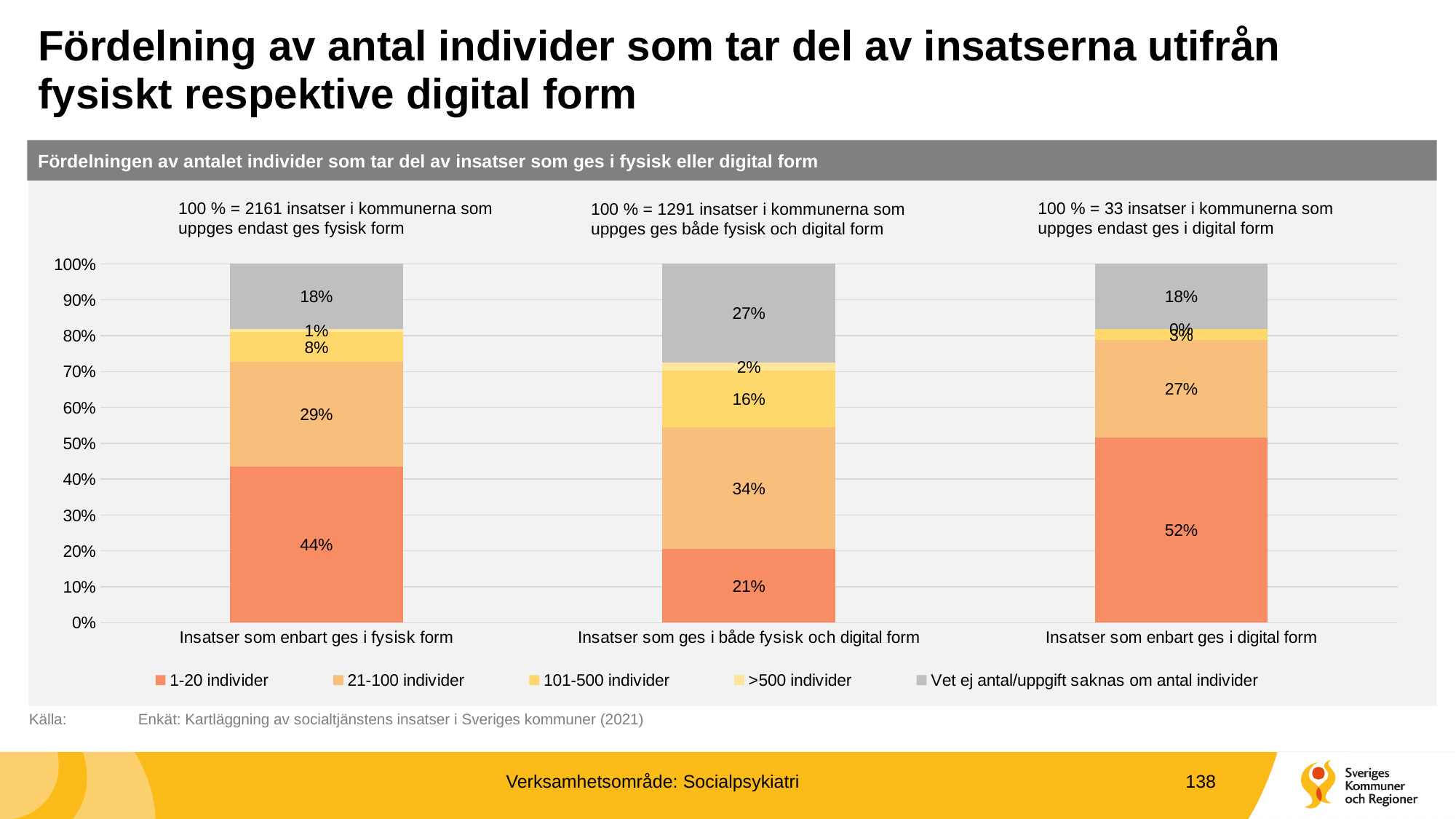
Which category has the highest share of '1-20 individer'? Insatser som enbart ges i digital form Which has a larger share of '21-100 individer': 'Insatser som enbart ges i fysisk form' or 'Insatser som ges i både fysisk och digital form'? Insatser som ges i både fysisk och digital form What is the share of '101-500 individer' for 'Insatser som ges i både fysisk och digital form'? 16% How many series does the legend list? 5 What is the share of 'Vet ej antal/uppgift saknas om antal individer' for 'Insatser som ges i både fysisk och digital form'? 27% What kind of chart is shown on the slide? Stacked bar chart What is the share of '21-100 individer' for 'Insatser som ges i både fysisk och digital form'? 34% What percentage of the 'Insatser som enbart ges i fysisk form' bar is '1-20 individer'? 44% What is the share of '1-20 individer' for 'Insatser som enbart ges i digital form'? 52% What is the difference in the '1-20 individer' share between 'Insatser som enbart ges i fysisk form' and 'Insatser som ges i både fysisk och digital form'? 23 percentage points Which category has the lowest share of '1-20 individer'? Insatser som ges i både fysisk och digital form How many categories are shown on the x axis of the chart? 3